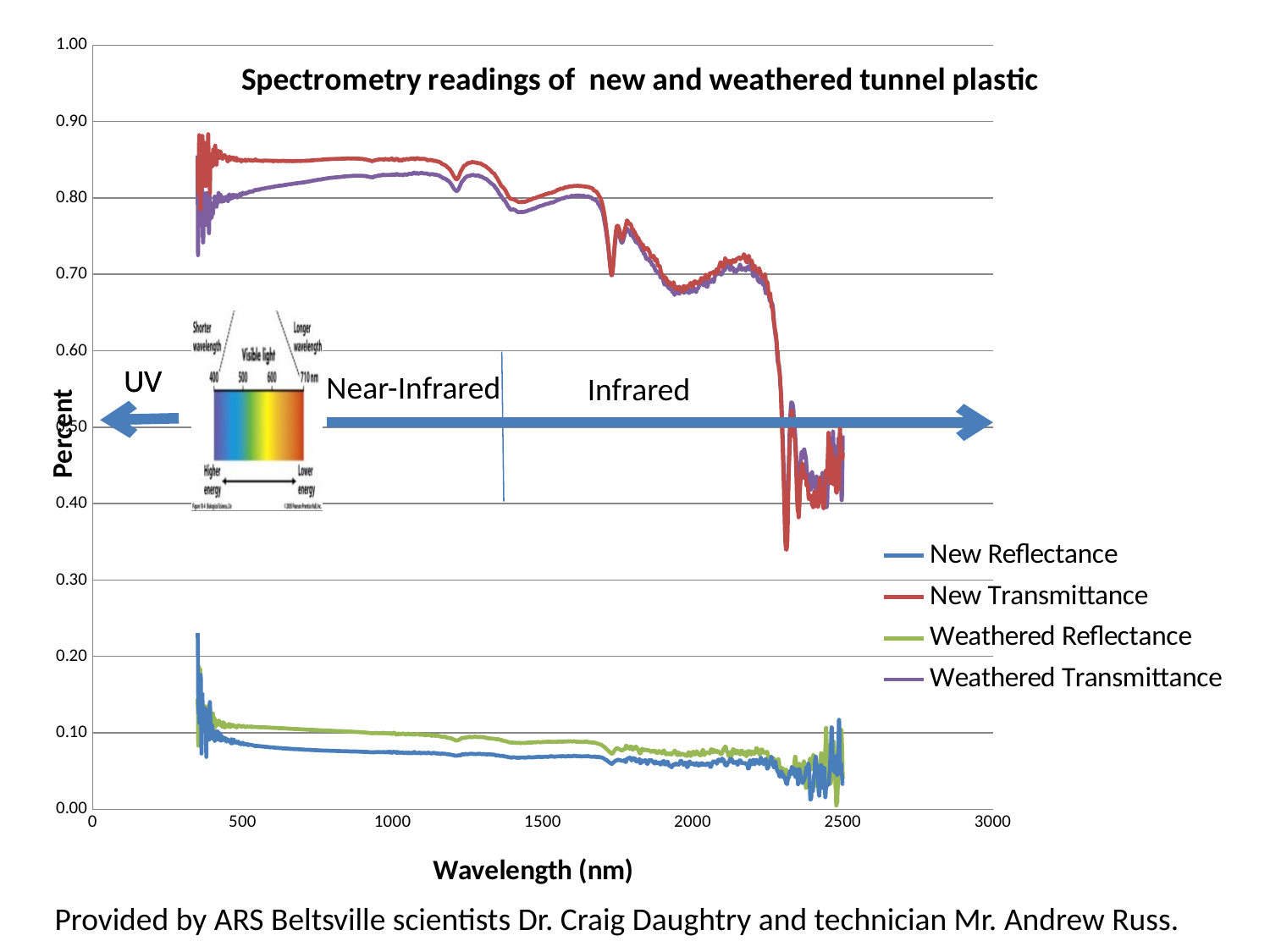
How many series does the legend list? 4 Is the value for Weathered Transmittance at 1000 nm greater or less than 0.90? less What kind of chart is shown on the slide? Line chart Which series has the highest values at around 1000 nm? New Transmittance Does the New Transmittance series rise or fall between 2000 nm and 2500 nm? Fall What is the title of the chart? Spectrometry readings of new and weathered tunnel plastic Is the value for New Transmittance at 1000 nm greater or less than 0.80? greater Is the value for Weathered Reflectance at 1000 nm greater or less than 0.20? less At 1000 nm, which is larger: Weathered Reflectance or New Reflectance? Weathered Reflectance At 1000 nm, which is larger: New Transmittance or Weathered Transmittance? New Transmittance What is the label of the x axis? Wavelength (nm)